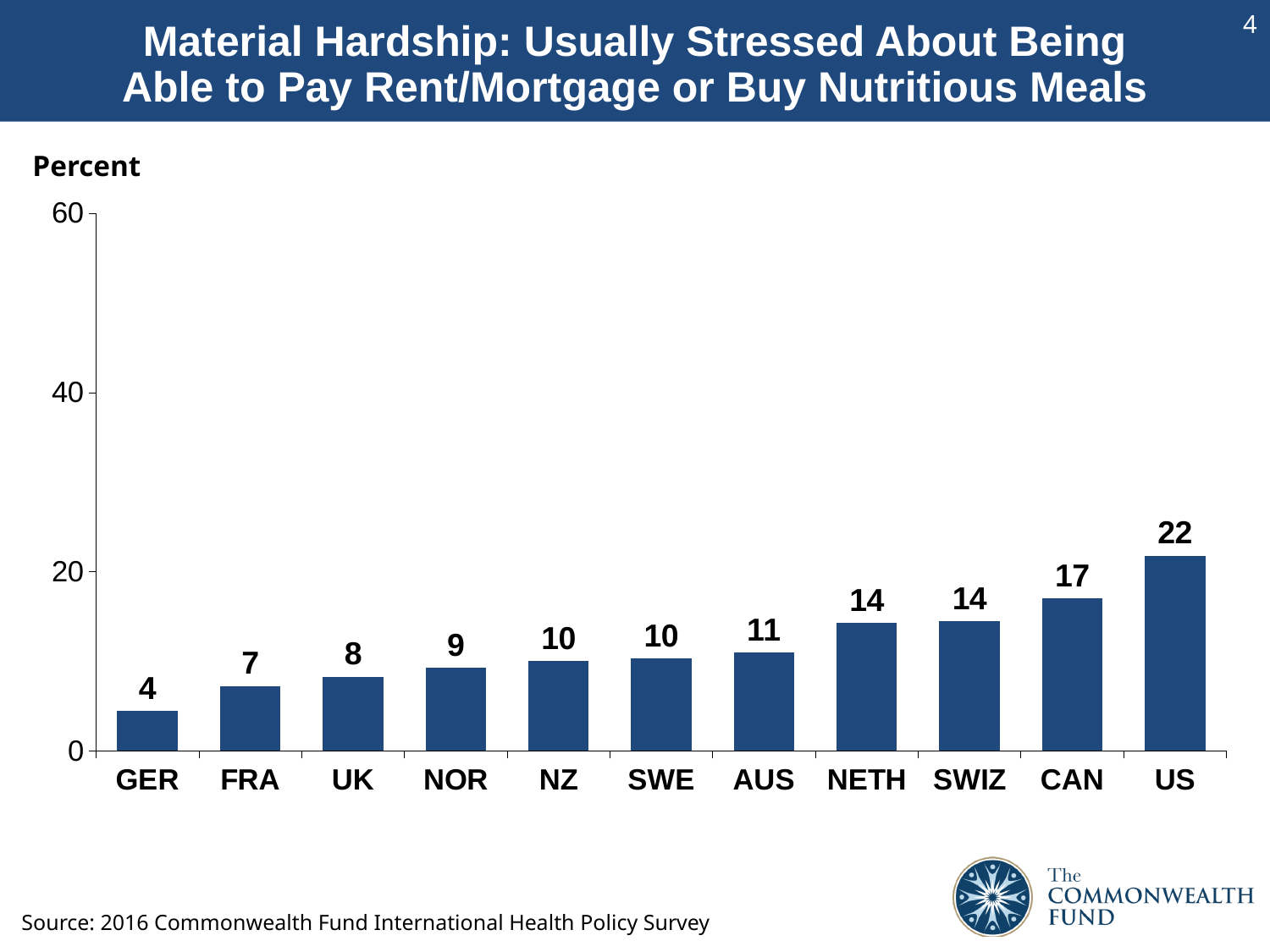
How many countries are shown on the chart? 11 Which country has the highest value? US What is the difference between the values for the US and CAN? 5 What is the value for NETH? 14 What is the difference between the values for SWIZ and FRA? 7 What is the value for GER? 4 Do the values rise or fall from GER to US along the x axis? rise Which is larger, the value for AUS or the value for UK? AUS What is the value for the US? 22 Is the value for CAN greater or less than 20? less Which country has the lowest value? GER What kind of chart is shown on the slide? bar chart